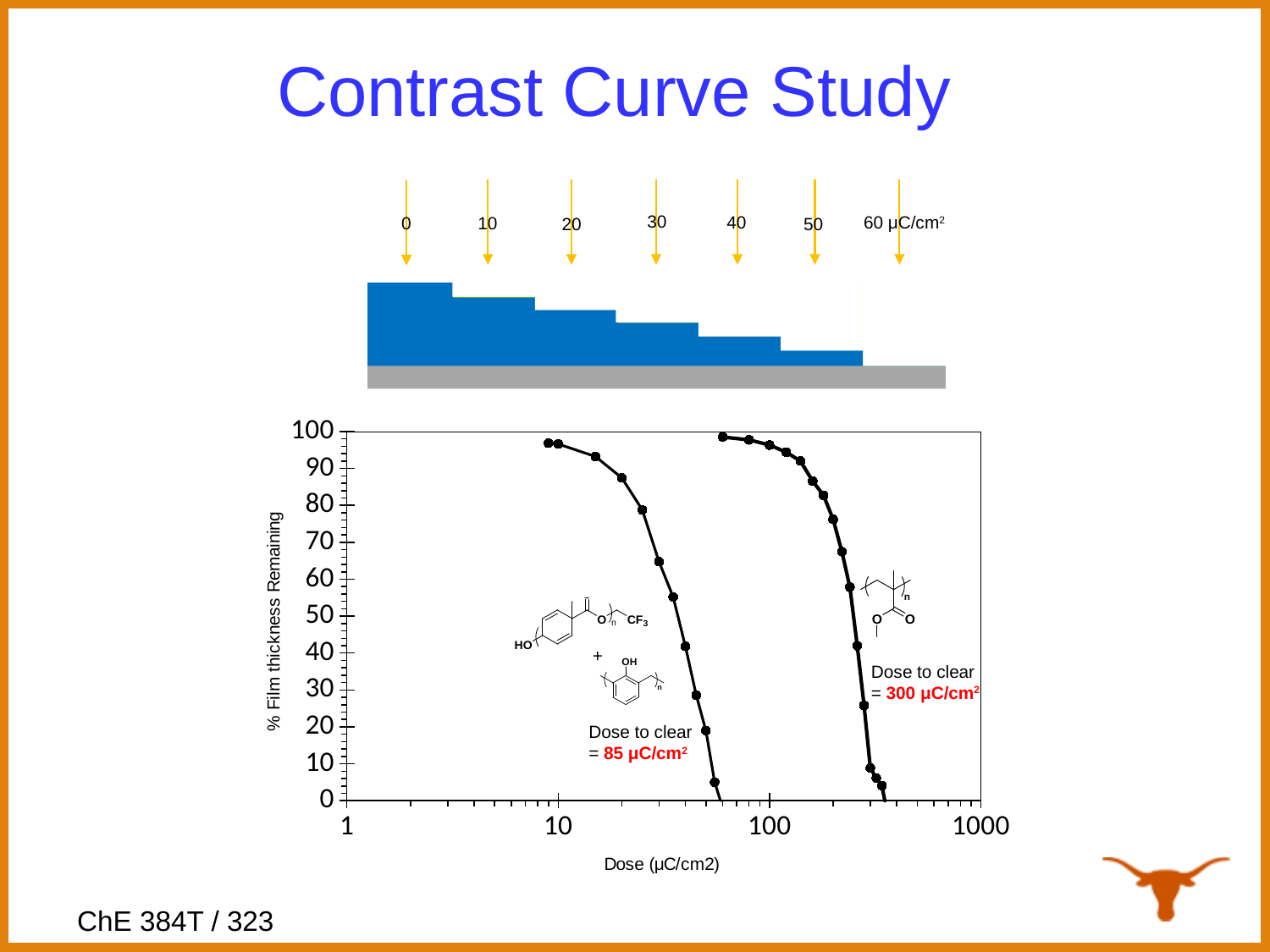
Is the % film thickness remaining for the left curve at a dose of 50 µC/cm² greater or less than 50? less What is the dose to clear for the right curve? 300 µC/cm² What kind of chart is shown on the slide? line chart What is the dose to clear for the left curve? 85 µC/cm² What is the highest value shown on the y axis? 100 What is the difference between the dose to clear of the right curve and the left curve? 215 µC/cm² What is the label of the x axis? Dose (µC/cm2) How many curves are plotted on the chart? 2 What is the label of the y axis? % Film thickness Remaining Is the % film thickness remaining for the right curve at a dose of 100 µC/cm² greater or less than 50? greater Does the % film thickness remaining rise or fall as the dose increases? fall Which curve has the larger dose to clear, the left one or the right one? the right curve